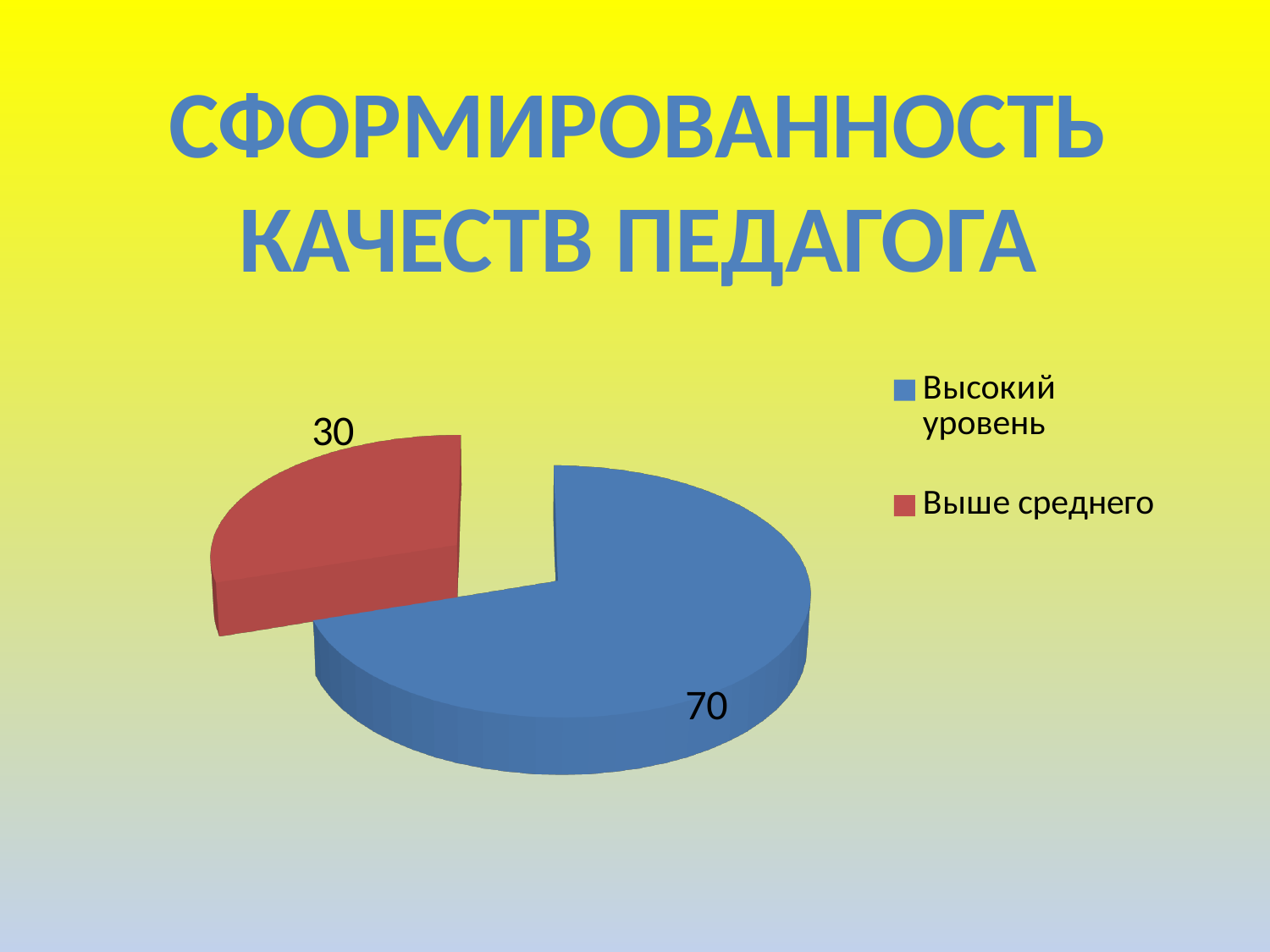
What is the difference between the values for Высокий уровень and Выше среднего? 40 What is the value for Выше среднего? 30 What colour is the slice for Выше среднего? Red What is the value for Высокий уровень? 70 Which is larger, the value for Высокий уровень or the value for Выше среднего? Высокий уровень How many entries does the legend list? 2 How many slices does the pie chart have? 2 Which category has the smallest slice of the pie? Выше среднего Which category has the largest slice of the pie? Высокий уровень What share of the pie does Высокий уровень represent? 70% What share of the pie does Выше среднего represent? 30% What kind of chart is shown on the slide? Pie chart